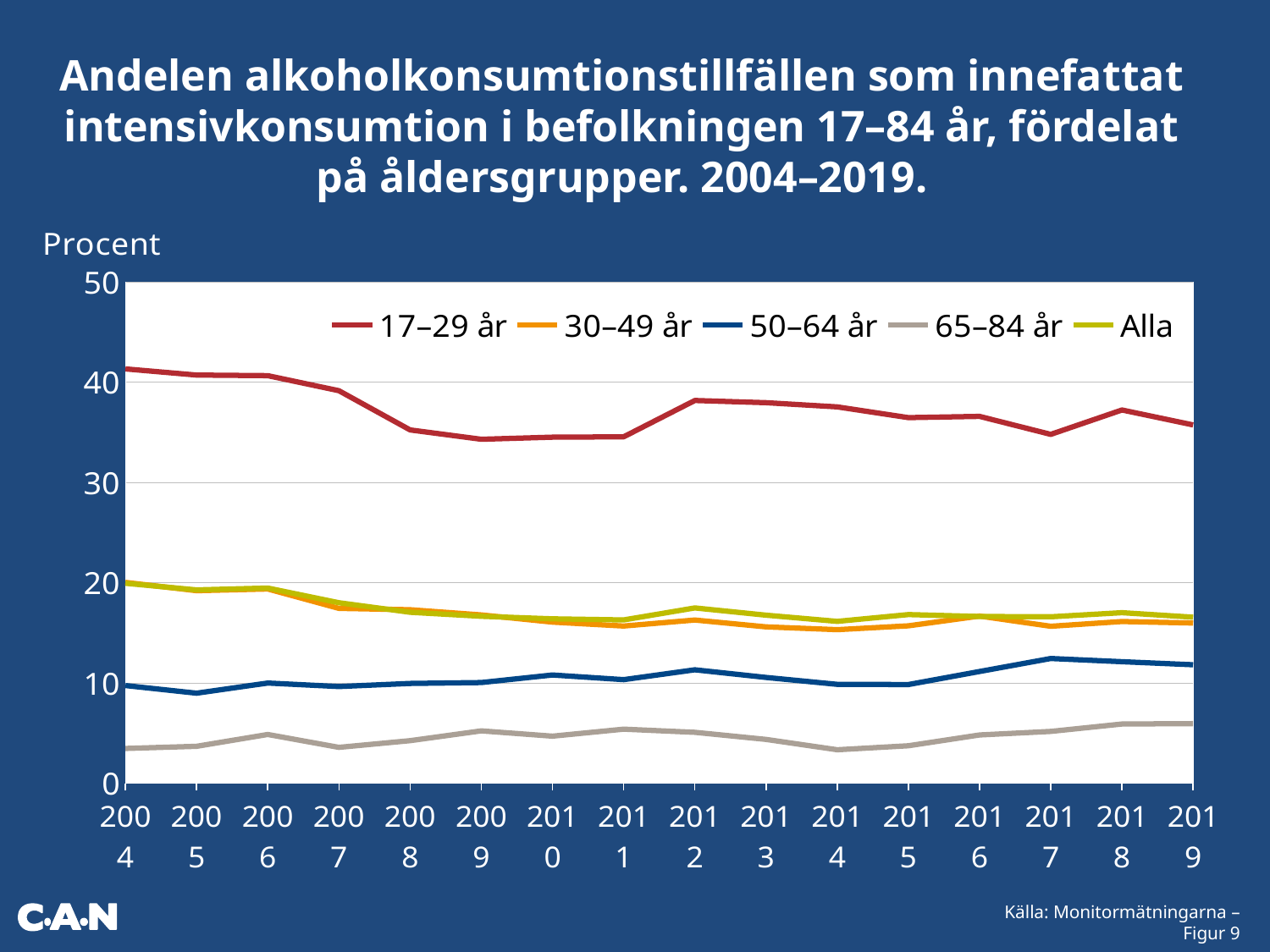
Is the value for 17–29 år in 2004 greater or less than 40? greater Which is larger in 2019, the value for 50–64 år or the value for 65–84 år? 50–64 år Does the value for 17–29 år rise or fall from 2004 to 2009? fall Which age group has the highest value in 2012? 17–29 år Which age group has the lowest value in 2019? 65–84 år What label is shown on the y axis? Procent How many years are shown along the x axis? 16 Is the value for 65–84 år in 2004 greater or less than 10? less What kind of chart is shown on the slide? line chart Is the value for 17–29 år in 2009 greater or less than 40? less How many series does the legend list? 5